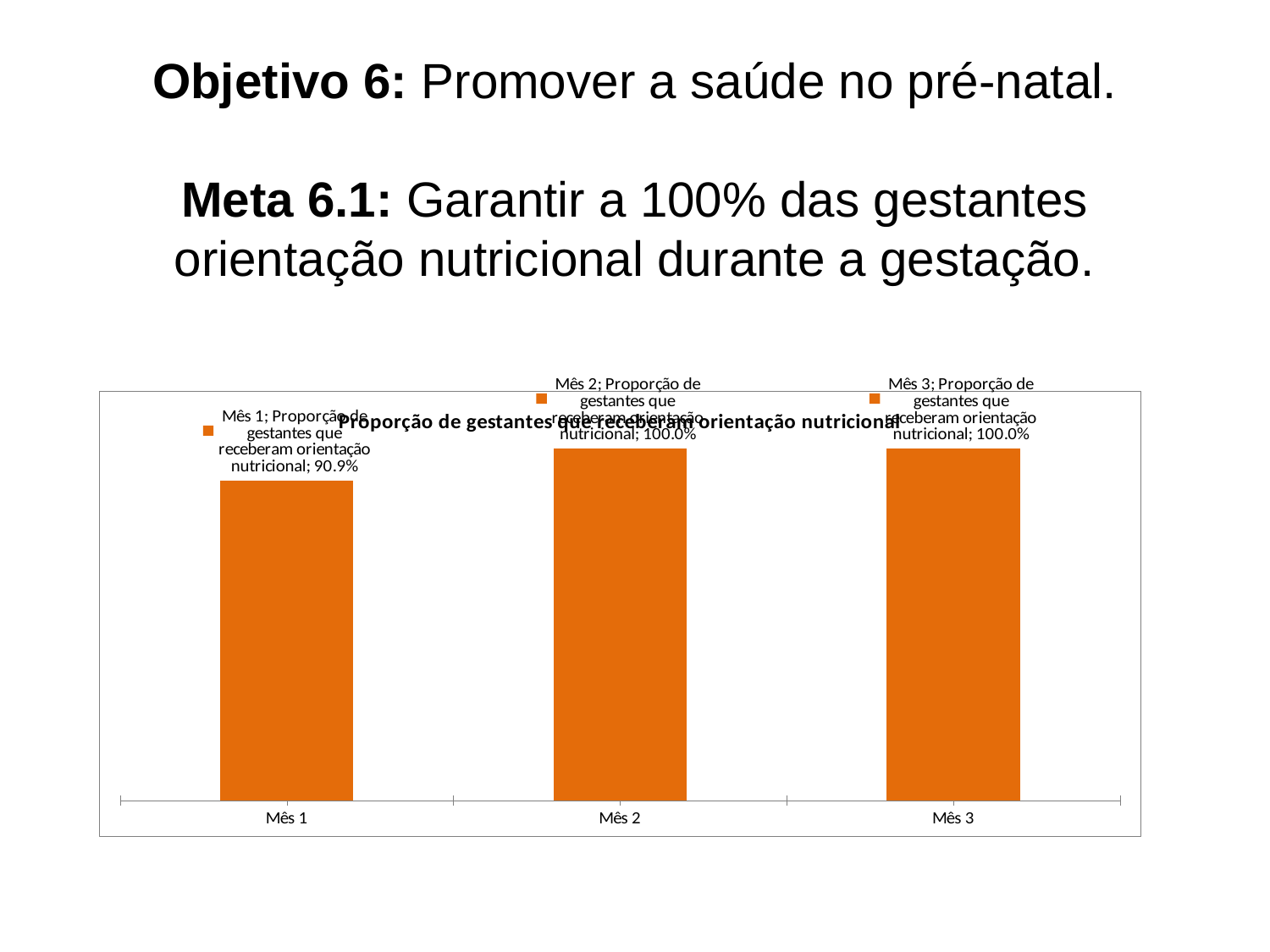
How many months (categories) are shown in the chart? 3 What colour are the bars in the chart? Orange What is the value for Mês 1 in the chart? 90.9% What is the title of the chart? Proporção de gestantes que receberam orientação nutricional Do Mês 2 and Mês 3 have the same value? Yes What is the value for Mês 2 in the chart? 100.0% What kind of chart is shown on the slide? Bar chart What is the value for Mês 3 in the chart? 100.0% Do the values rise or fall from Mês 1 to Mês 2? Rise Which month has the lowest proportion of pregnant women who received nutritional guidance? Mês 1 Which is larger, the value for Mês 1 or the value for Mês 2? Mês 2 What is the difference between the value for Mês 2 and the value for Mês 1? 9.1%